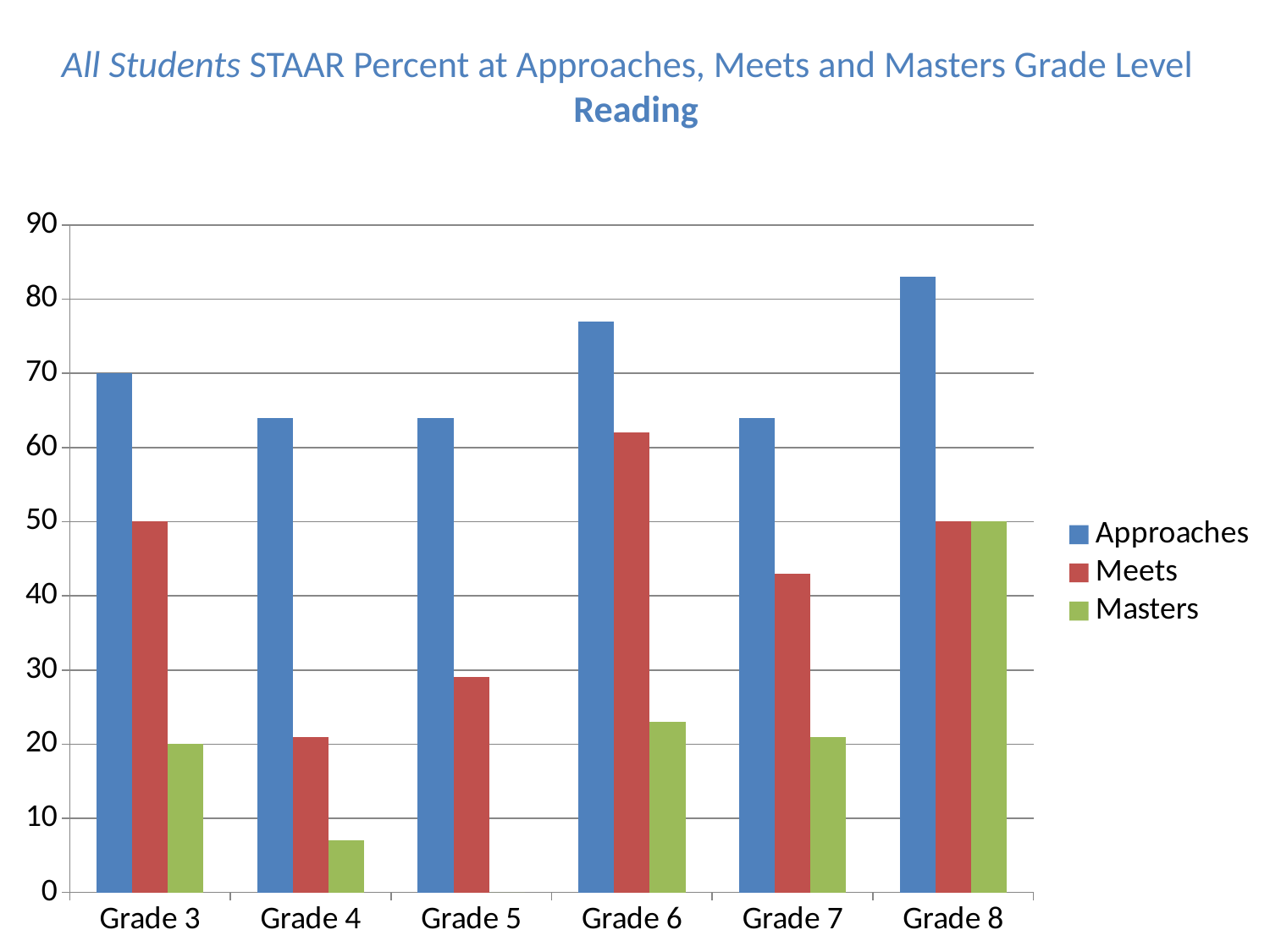
Is the Approaches value for Grade 6 greater or less than 70? greater Which grade has the highest Meets value? Grade 6 Which grade has the lowest Meets value? Grade 4 Which grade has the highest Approaches value? Grade 8 What type of chart is shown on the slide? bar chart How many grade levels are shown on the x axis? 6 Is the Meets value for Grade 4 greater or less than 30? less What is the difference between the Approaches and Meets values for Grade 3? 20 How many series does the legend list? 3 What is the Masters value for Grade 8? 50 What is the Meets value for Grade 3? 50 What is the Approaches value for Grade 3? 70